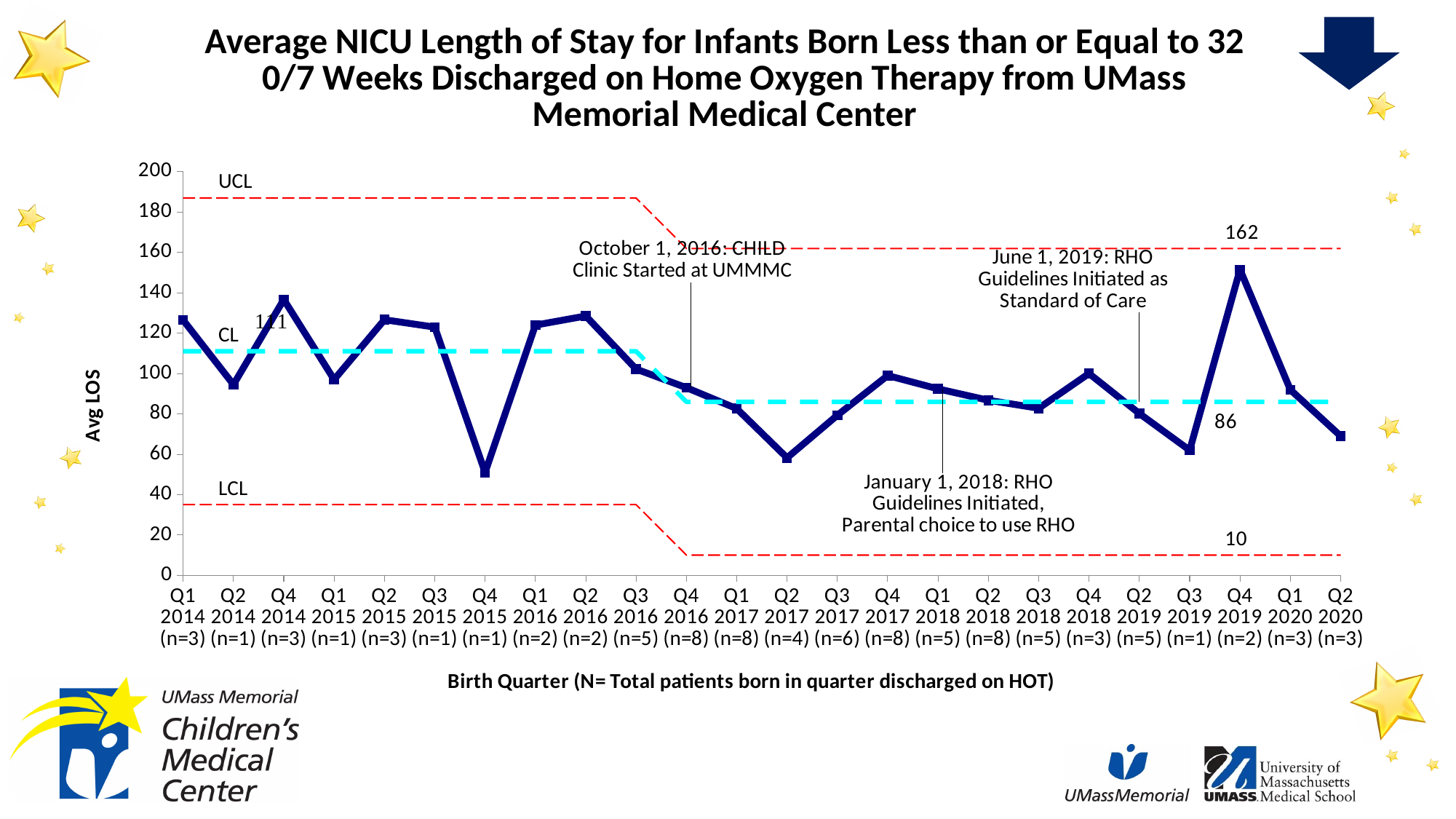
What is the value of the center line (CL) labelled in the first phase of the chart? 111 Is the average LOS for Q4 2019 greater or less than 140? greater What kind of chart is shown on the slide? line chart Is the average LOS for Q2 2020 greater or less than 80? less What is the value of the center line (CL) labelled in the later phase of the chart? 86 Which has a higher average LOS, Q4 2014 or Q1 2015? Q4 2014 What is the title of the y axis? Avg LOS What is the value of the lower control limit (LCL) labelled in the later phase of the chart? 10 Which birth quarter has the highest average NICU length of stay? Q4 2019 How many birth quarters are plotted on the x axis? 24 Which birth quarter has the lowest average NICU length of stay? Q4 2015 What is the value of the upper control limit (UCL) labelled in the later phase of the chart? 162